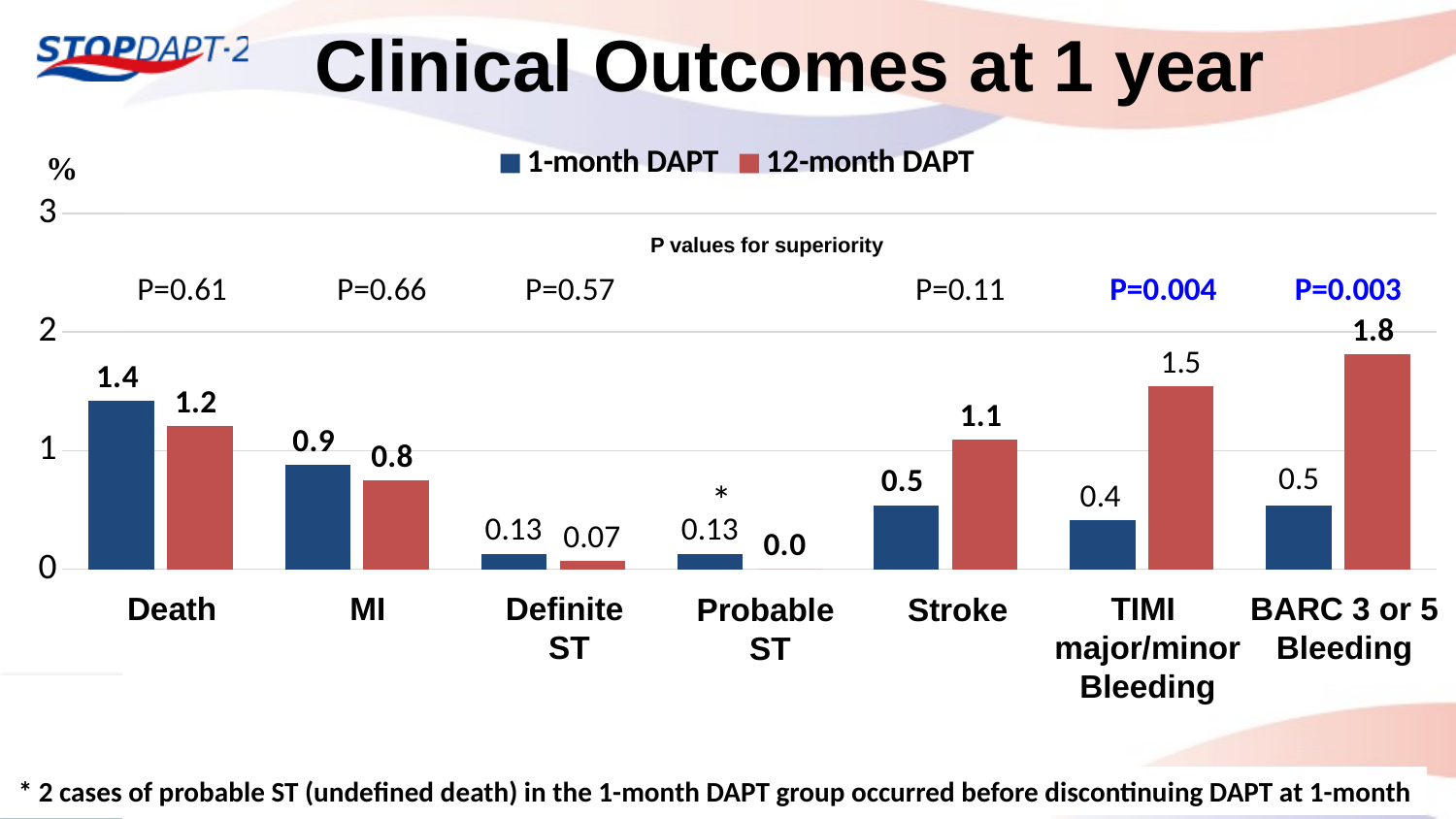
What is the difference between the 12-month DAPT and 1-month DAPT values for BARC 3 or 5 Bleeding? 1.3 Which is larger for Stroke: the 1-month DAPT value or the 12-month DAPT value? 12-month DAPT What is the value for 12-month DAPT in the Probable ST category? 0.0 Is the value for 12-month DAPT in the TIMI major/minor Bleeding category greater or less than 1? greater What is the value for 1-month DAPT in the TIMI major/minor Bleeding category? 0.4 Which category has the lowest value for 12-month DAPT? Probable ST How many categories are shown on the x axis? 7 How many series does the legend list? 2 What is the value for 1-month DAPT in the Death category? 1.4 Which category has the highest value for 12-month DAPT? BARC 3 or 5 Bleeding What is the value for 12-month DAPT in the BARC 3 or 5 Bleeding category? 1.8 What kind of chart is shown on the slide? Bar chart